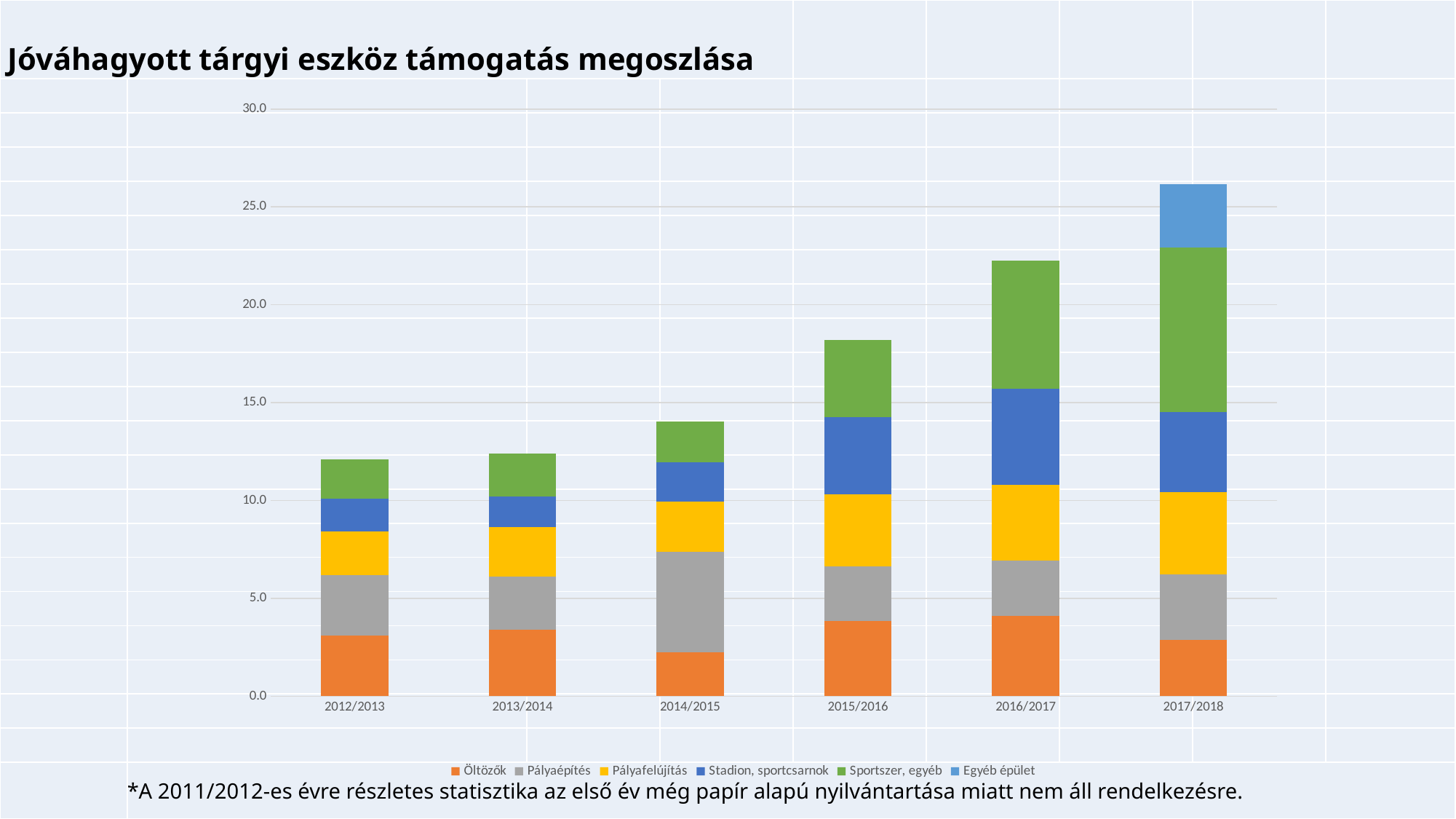
Is the total for 2014/2015 greater or less than 15.0? less What kind of chart is shown on the slide? stacked bar chart Is the total for 2012/2013 greater or less than 10.0? greater Which has the larger total, 2015/2016 or 2016/2017? 2016/2017 Is the total for 2015/2016 greater or less than 20.0? less How many seasons (categories) are shown on the x axis? 6 What is the title of the chart? Jóváhagyott tárgyi eszköz támogatás megoszlása Which season has the tallest stacked bar? 2017/2018 Do the stacked bar totals generally rise or fall from 2012/2013 to 2017/2018? rise How many series does the legend list? 6